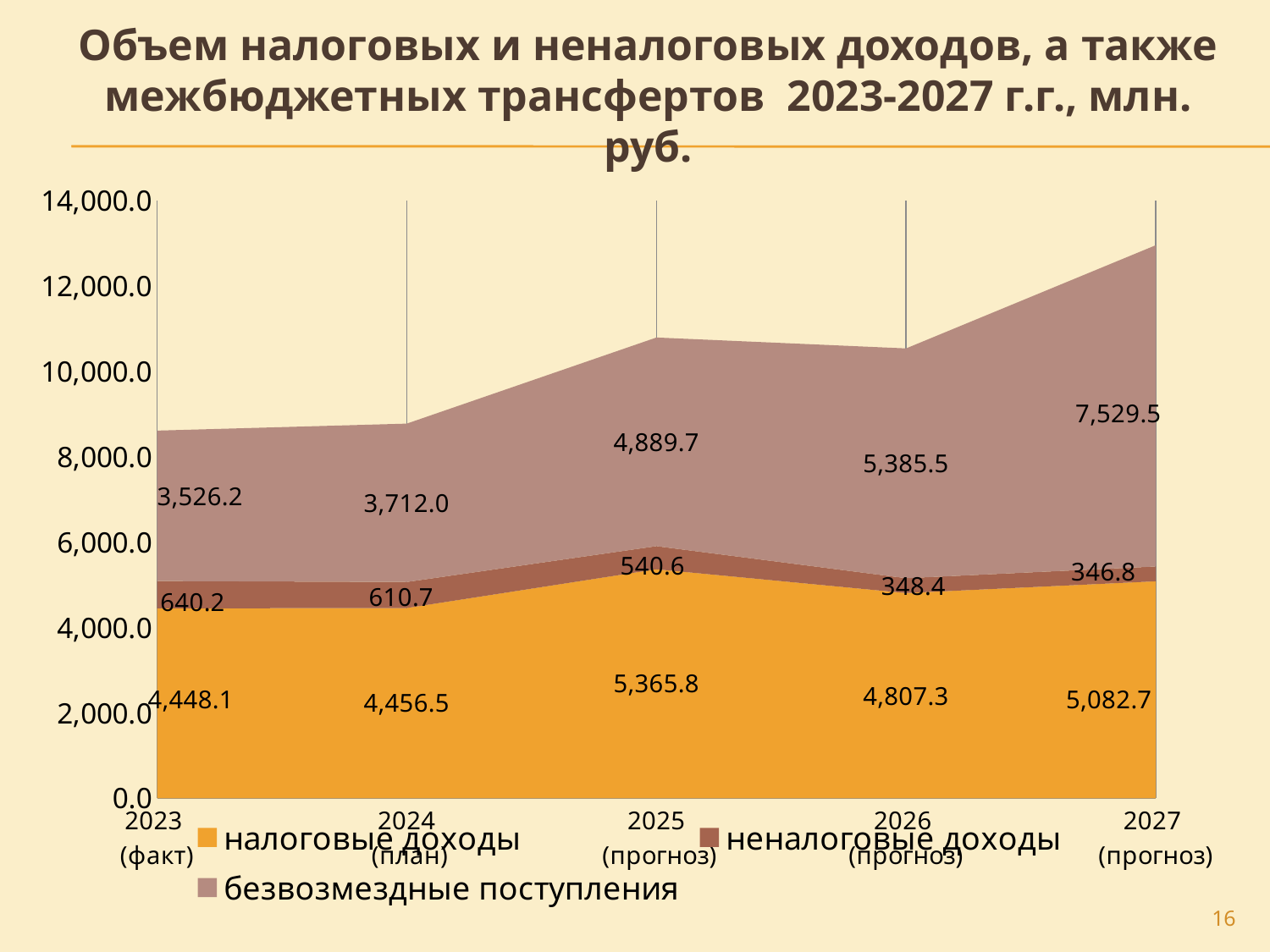
What is the total of the three series for 2027 (прогноз)? 12,959.0 How many years are shown on the x axis? 5 What kind of chart is shown on the slide? area chart What is the value of неналоговые доходы for 2023 (факт)? 640.2 What is the value of налоговые доходы for 2025 (прогноз)? 5,365.8 In which year are неналоговые доходы lowest? 2027 What is the value of безвозмездные поступления for 2027 (прогноз)? 7,529.5 How many series does the legend list? 3 Do неналоговые доходы rise or fall from 2023 to 2027? fall In which year are безвозмездные поступления highest? 2027 What is the difference between безвозмездные поступления in 2027 and in 2023? 4,003.3 Which is larger in 2026: налоговые доходы or безвозмездные поступления? безвозмездные поступления